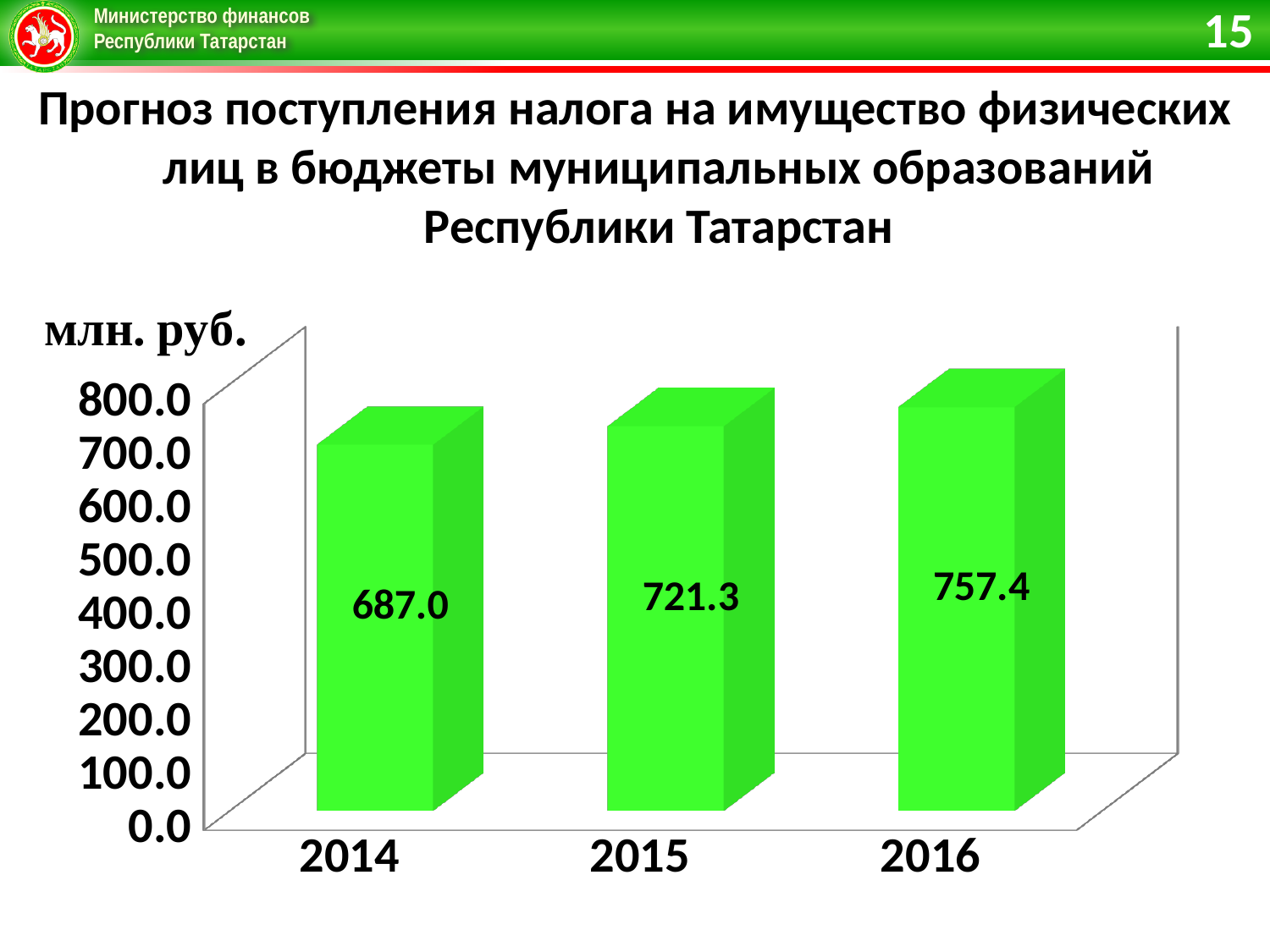
Do the values rise or fall from 2014 to 2016? rise Which year has the lowest forecast value? 2014 What is the difference between the 2015 and 2014 values? 34.3 What is the forecast value for 2016? 757.4 What kind of chart is shown on the slide? bar chart Which year has the highest forecast value? 2016 Which is larger, the value for 2015 or the value for 2016? 2016 What is the difference between the 2016 and 2014 values? 70.4 How many years are shown on the chart? 3 Is the value for 2014 greater or less than 700.0? less What is the forecast value for 2015? 721.3 What is the forecast value for 2014? 687.0